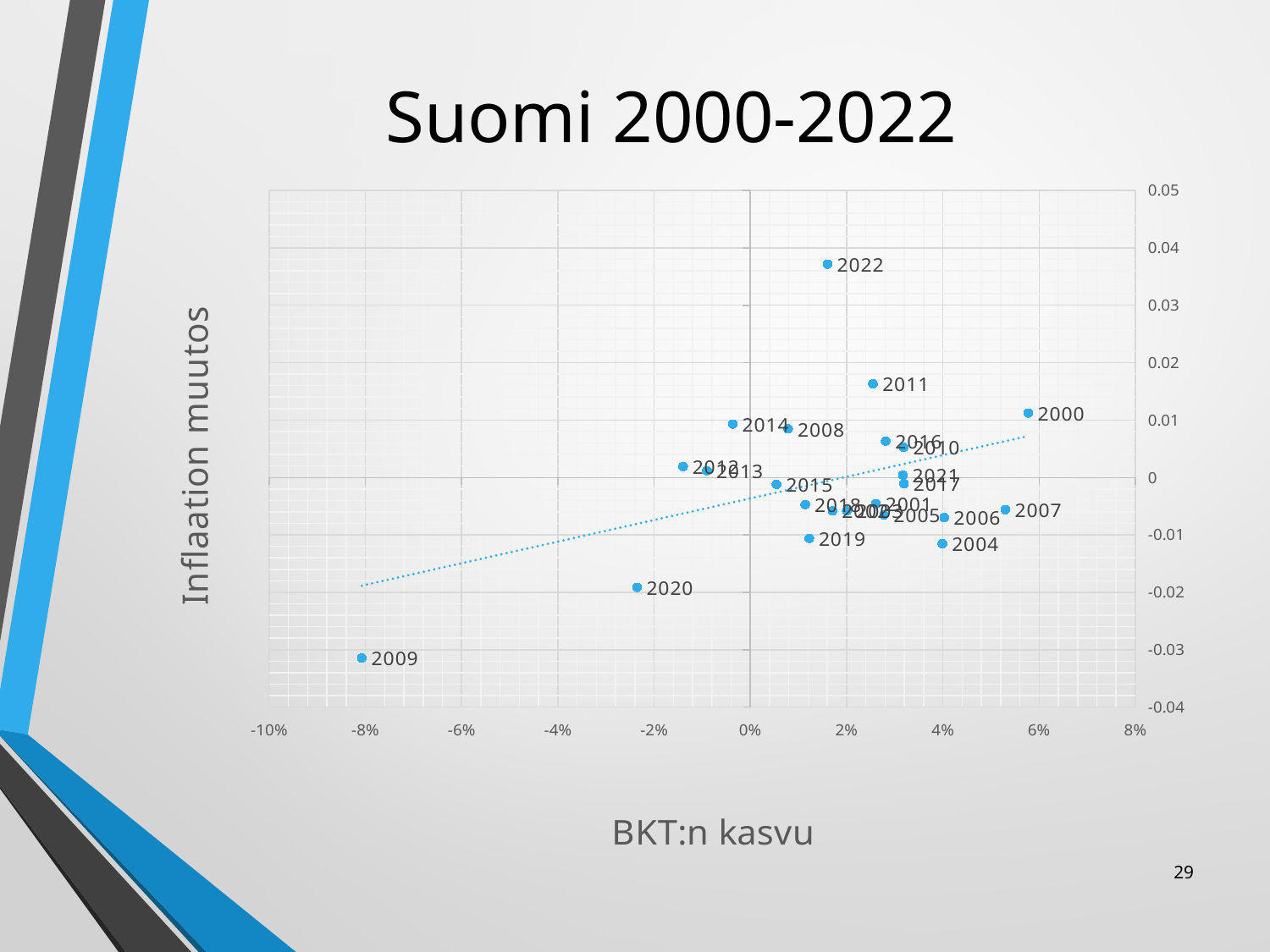
Which year has the lowest value on the vertical axis (Inflaation muutos)? 2009 What kind of chart is shown on the slide? Scatter chart Which year has the lowest value on the horizontal axis (BKT:n kasvu)? 2009 Is the Inflaation muutos value for 2022 greater or less than 0.03? greater What is the title of the chart? Suomi 2000-2022 Is the BKT:n kasvu value for 2000 greater or less than 4%? greater Which year has the higher Inflaation muutos value, 2022 or 2011? 2022 Is the Inflaation muutos value for 2020 greater or less than -0.01? less What is the label of the horizontal axis? BKT:n kasvu Does the dotted trend line rise or fall as BKT:n kasvu increases? Rises Which year has the highest value on the vertical axis (Inflaation muutos)? 2022